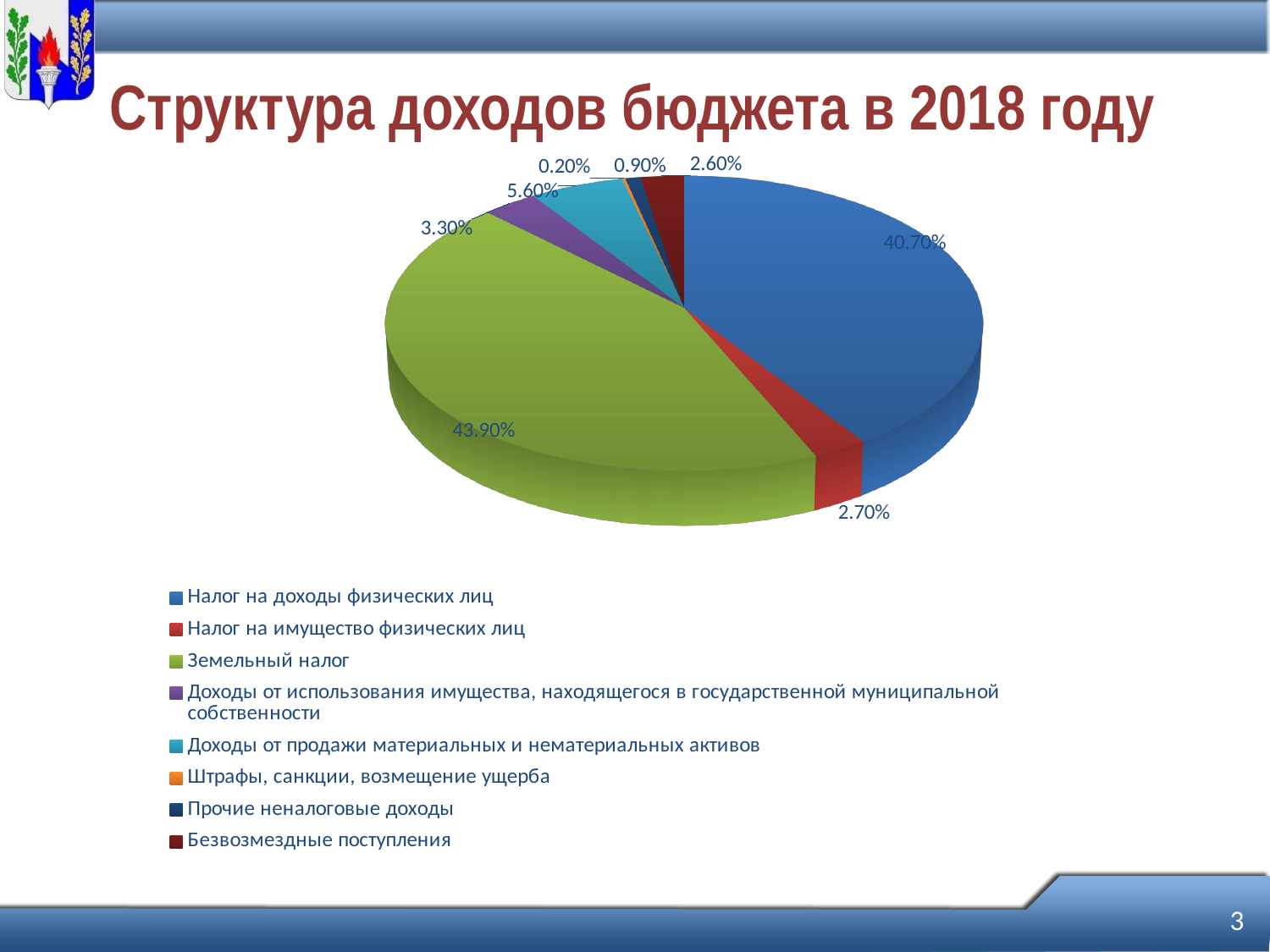
What is the value shown for Доходы от продажи материальных и нематериальных активов? 5.60% What is the difference between the shares of Земельный налог and Налог на доходы физических лиц? 3.20% What is the value shown for Безвозмездные поступления? 2.60% Which category has the smallest share of the pie? Штрафы, санкции, возмещение ущерба What is the title of the chart? Структура доходов бюджета в 2018 году What share of the pie does Земельный налог represent? 43.90% How many categories does the pie chart show? 8 Which is larger: the share of Налог на имущество физических лиц or the share of Доходы от использования имущества, находящегося в государственной муниципальной собственности? Доходы от использования имущества, находящегося в государственной муниципальной собственности What share of the pie does Налог на доходы физических лиц represent? 40.70% What is the value shown for Штрафы, санкции, возмещение ущерба? 0.20% What type of chart is shown on the slide? Pie chart Which category has the largest share of the pie? Земельный налог